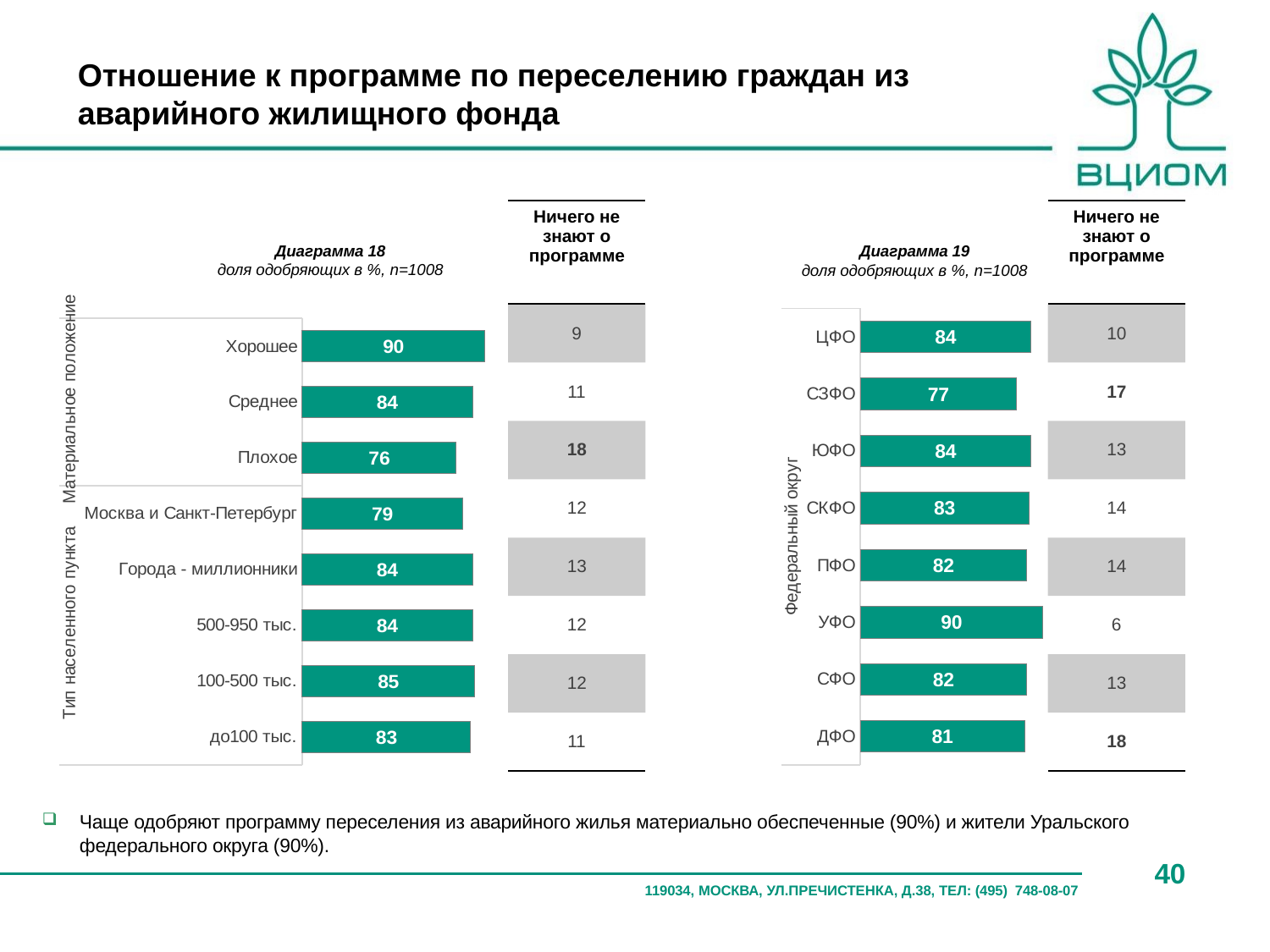
In Диаграмма 19, what is the value for УФО? 90 In Диаграмма 18, how many categories are plotted? 8 In Диаграмма 19, what is the difference between the values for УФО and СЗФО? 13 In Диаграмма 19, what kind of chart is shown? Bar chart In Диаграмма 18, which is larger: the value for Москва и Санкт-Петербург or the value for 100-500 тыс.? 100-500 тыс. In Диаграмма 18, what is the difference between the values for Хорошее and Плохое? 14 In Диаграмма 18, what is the value for Плохое? 76 In Диаграмма 19, what is the value for СЗФО? 77 In Диаграмма 18, what is the value for Хорошее? 90 In Диаграмма 18, which category has the lowest value? Плохое In Диаграмма 19, how many federal districts are plotted? 8 In Диаграмма 19, which federal district has the highest value? УФО